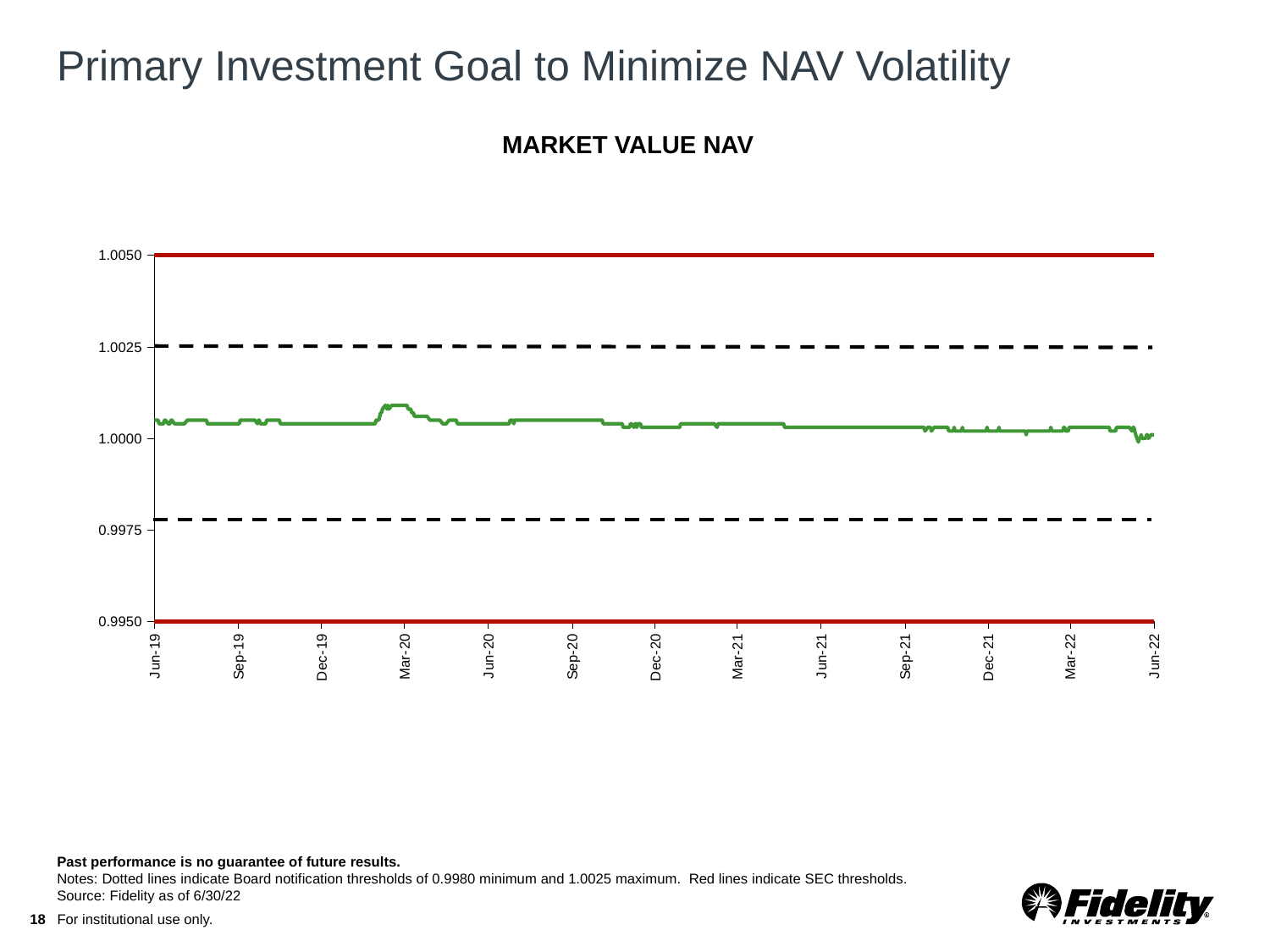
What is the title of the chart? MARKET VALUE NAV Is the NAV value at Jun-19 greater or less than 1.0025? less At what y-axis value is the upper red line drawn? 1.0050 Around which x-axis date does the green NAV line reach its lowest point? Jun-22 At what y-axis value is the upper dashed line drawn? 1.0025 Is the NAV value at Dec-21 greater or less than 0.9975? greater How many date labels are shown on the x axis? 13 Is the NAV value at Mar-20 greater or less than 1.0000? greater What kind of chart is shown on the slide? line chart At what y-axis value is the lower red line drawn? 0.9950 Around which x-axis date does the green NAV line reach its highest point? Mar-20